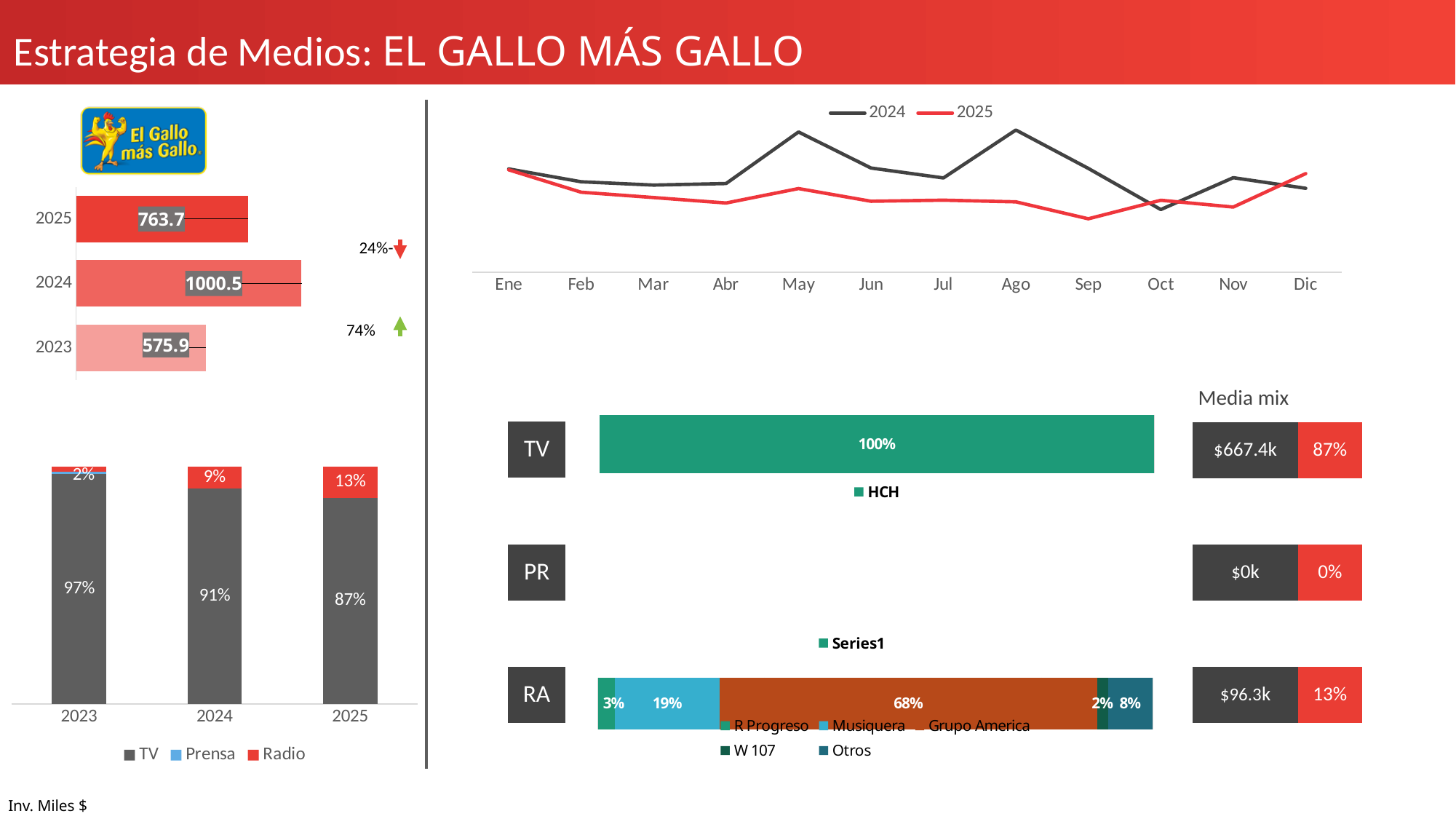
In the Media mix table on the right, what is the amount for TV? $667.4k In the top-left bar chart of yearly investment, what is the value for 2024? 1000.5 In the bottom-left stacked bar chart, how many series does the legend list? 3 In the top-left bar chart of yearly investment, which year has the highest value? 2024 In the bottom-left stacked bar chart, what share does TV have in 2025? 87% In the bottom-left stacked bar chart, what share does Radio have in 2024? 9% In the top-left bar chart of yearly investment, what is the difference between the 2024 and 2025 values? 236.8 In the top-right line chart, how many months are shown on the x axis? 12 In the top-right line chart, which series is higher in May, 2024 or 2025? 2024 What kind of chart is the bottom-left chart showing TV, Prensa and Radio by year? Stacked bar chart In the RA bar on the right, what share does Grupo America have? 68% In the top-left bar chart of yearly investment, what is the value for 2023? 575.9